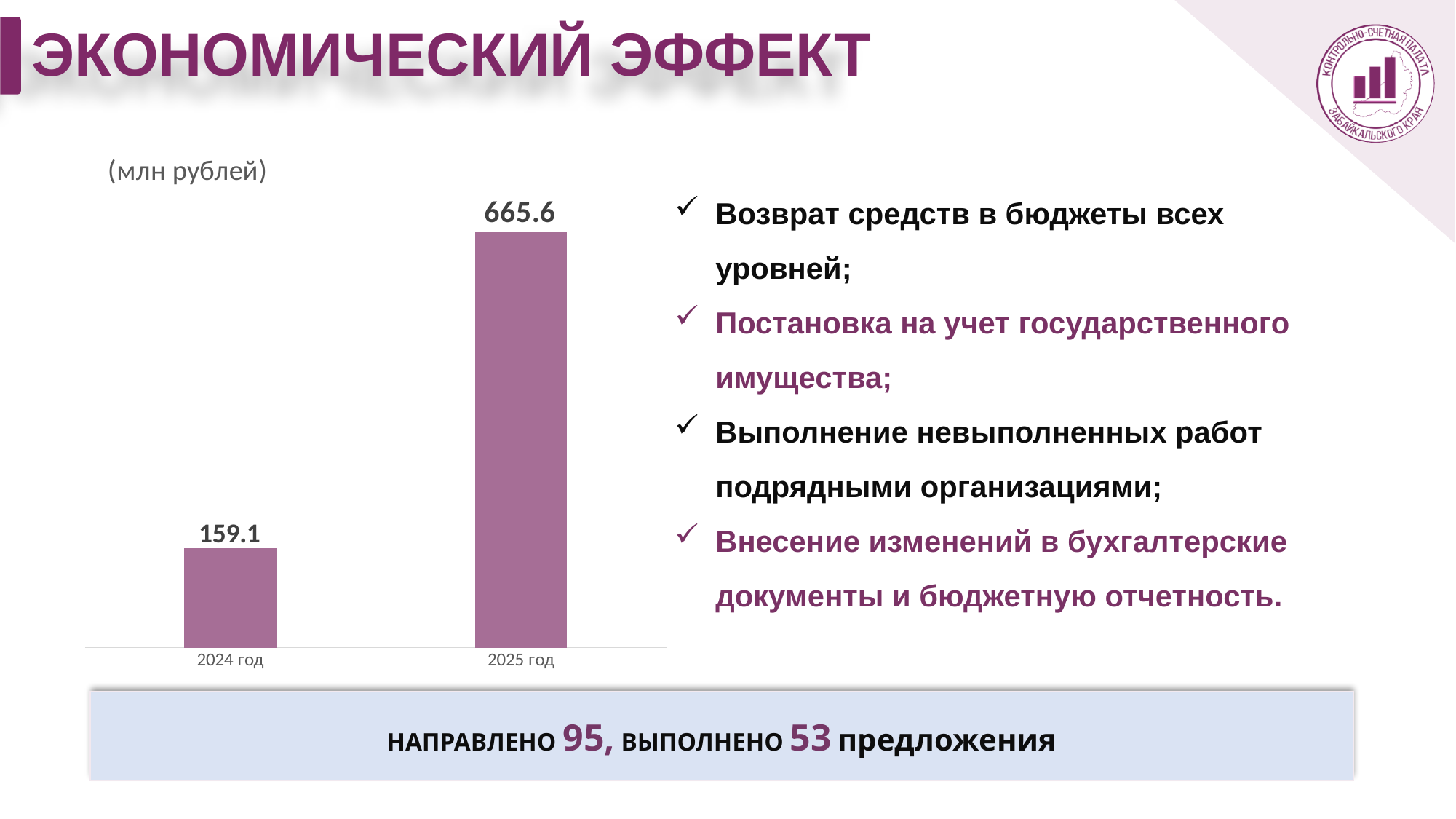
What is the value for 2025 год? 665.6 Which year has the lowest value? 2024 год Which year has the highest value? 2025 год What is the title of the slide containing the chart? ЭКОНОМИЧЕСКИЙ ЭФФЕКТ Which is larger, the value for 2024 год or 2025 год? 2025 год Do the values rise or fall from 2024 год to 2025 год? rise What unit is indicated for the chart values? млн рублей How many categories are shown in the chart? 2 What is the value for 2024 год? 159.1 What kind of chart is shown on the slide? bar chart What is the difference between the values for 2025 год and 2024 год? 506.5